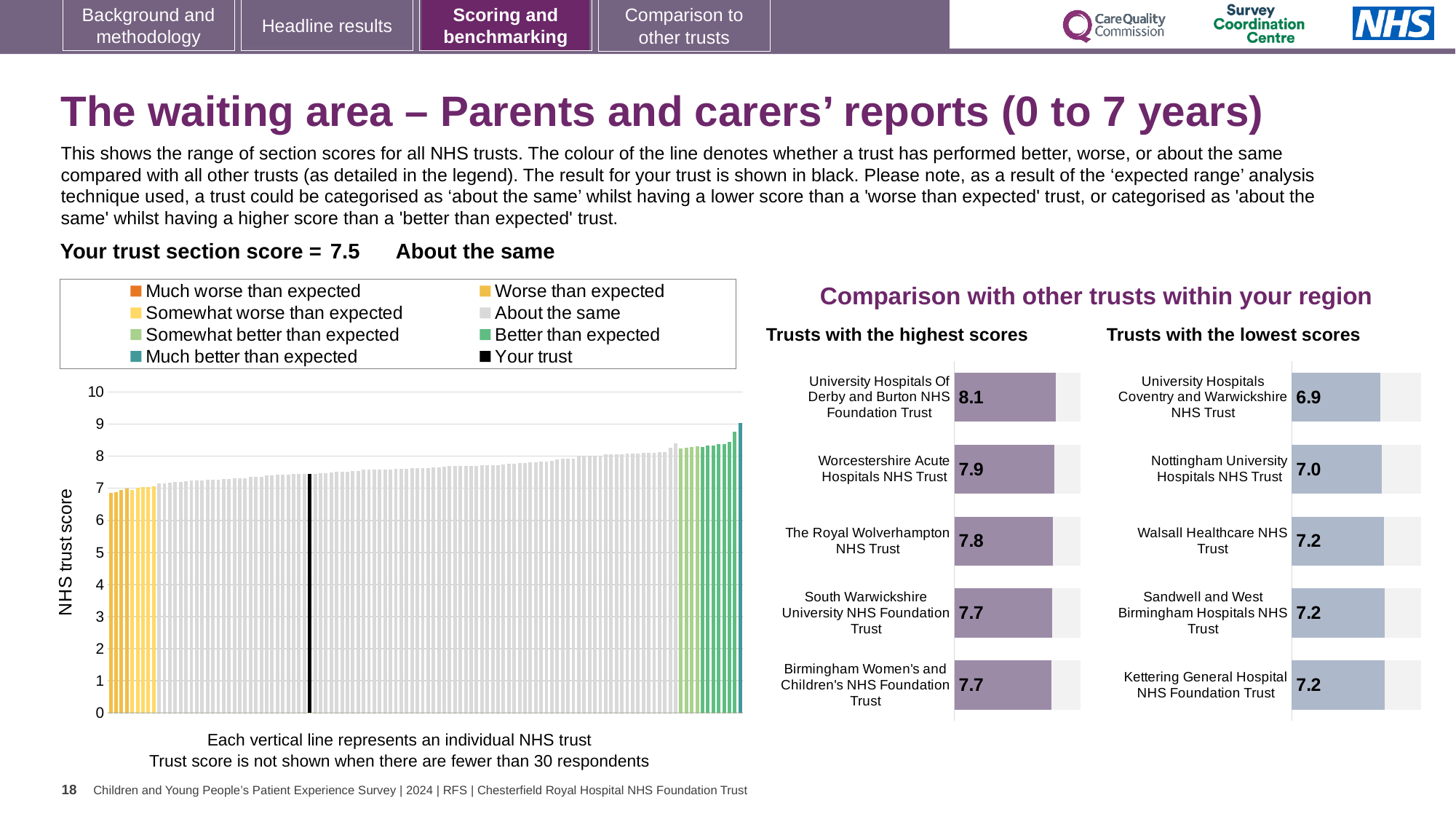
In the 'Trusts with the highest scores' chart, what is the difference between the scores of University Hospitals Of Derby and Burton NHS Foundation Trust and Worcestershire Acute Hospitals NHS Trust? 0.2 In the 'Trusts with the highest scores' chart, which trust has the highest score? University Hospitals Of Derby and Burton NHS Foundation Trust In the 'Trusts with the highest scores' chart, what is the score for University Hospitals Of Derby and Burton NHS Foundation Trust? 8.1 In the main NHS trust score chart on the left, do the bar values rise or fall from left to right? rise In the 'Trusts with the lowest scores' chart, what is the score for Nottingham University Hospitals NHS Trust? 7.0 How many trusts are shown in the 'Trusts with the lowest scores' chart? 5 In the 'Trusts with the highest scores' chart, what is the score for The Royal Wolverhampton NHS Trust? 7.8 In the main NHS trust score chart on the left, is the value for the black 'Your trust' bar greater or less than 8? less How many entries does the legend of the main NHS trust score chart list? 8 In the 'Trusts with the lowest scores' chart, what is the difference between the scores of Walsall Healthcare NHS Trust and University Hospitals Coventry and Warwickshire NHS Trust? 0.3 In the 'Trusts with the lowest scores' chart, which trust has the lowest score? University Hospitals Coventry and Warwickshire NHS Trust Which has a higher score: Worcestershire Acute Hospitals NHS Trust in the highest scores chart or Nottingham University Hospitals NHS Trust in the lowest scores chart? Worcestershire Acute Hospitals NHS Trust